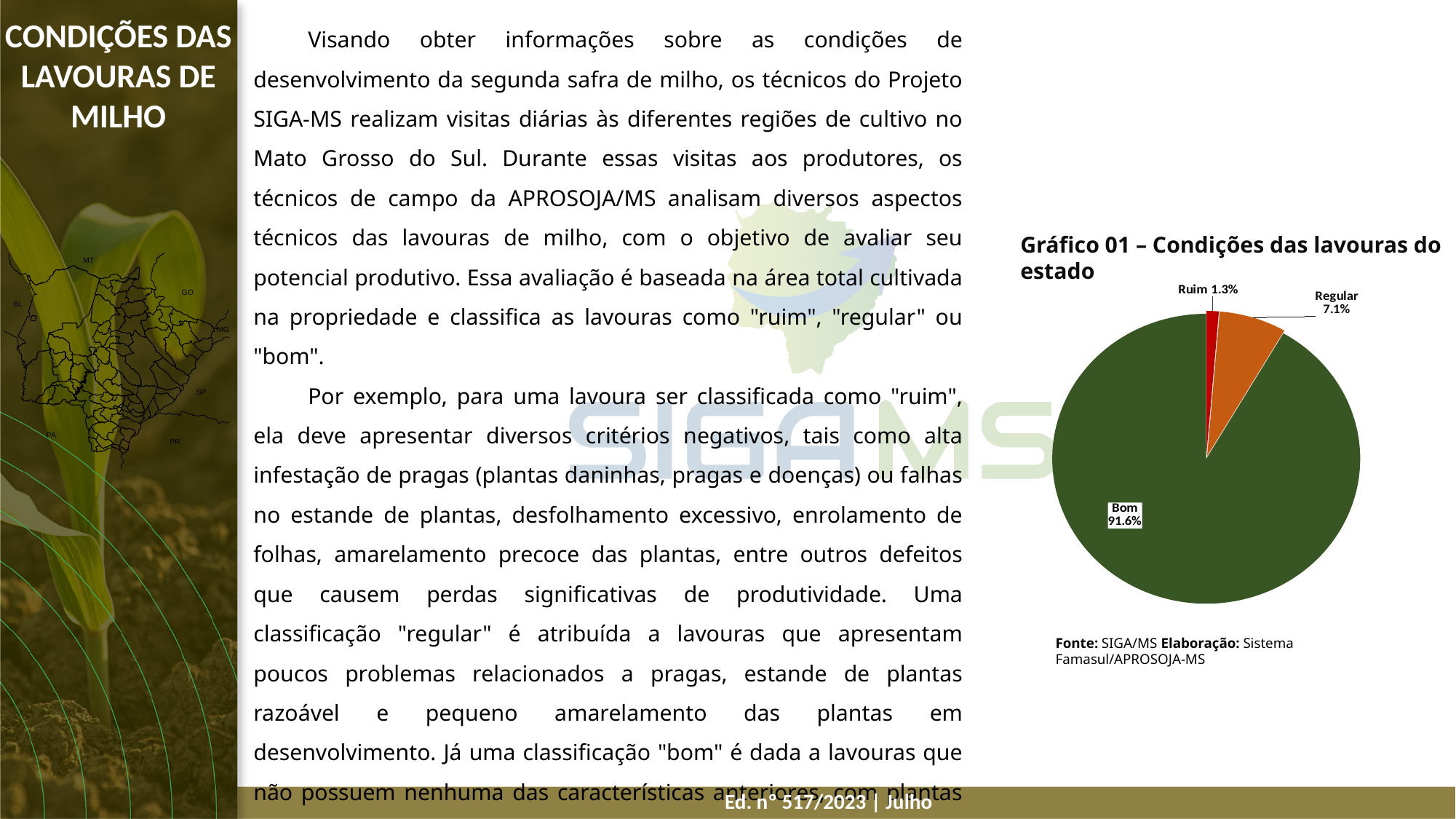
Which category has the smallest slice of the pie? Ruim Which is larger, the value for "Regular" or the value for "Ruim"? Regular Which category has the largest slice of the pie? Bom What is the value shown for "Regular"? 7.1% What colour is the "Bom" slice? dark green What is the title of the chart? Gráfico 01 – Condições das lavouras do estado How many slices does the pie chart have? 3 What kind of chart is Gráfico 01? pie chart What share of the pie does the "Bom" slice represent? 91.6% What is the difference between the "Regular" and "Ruim" values? 5.8% What is the value shown for "Ruim"? 1.3% What is the difference between the "Bom" and "Regular" values? 84.5%